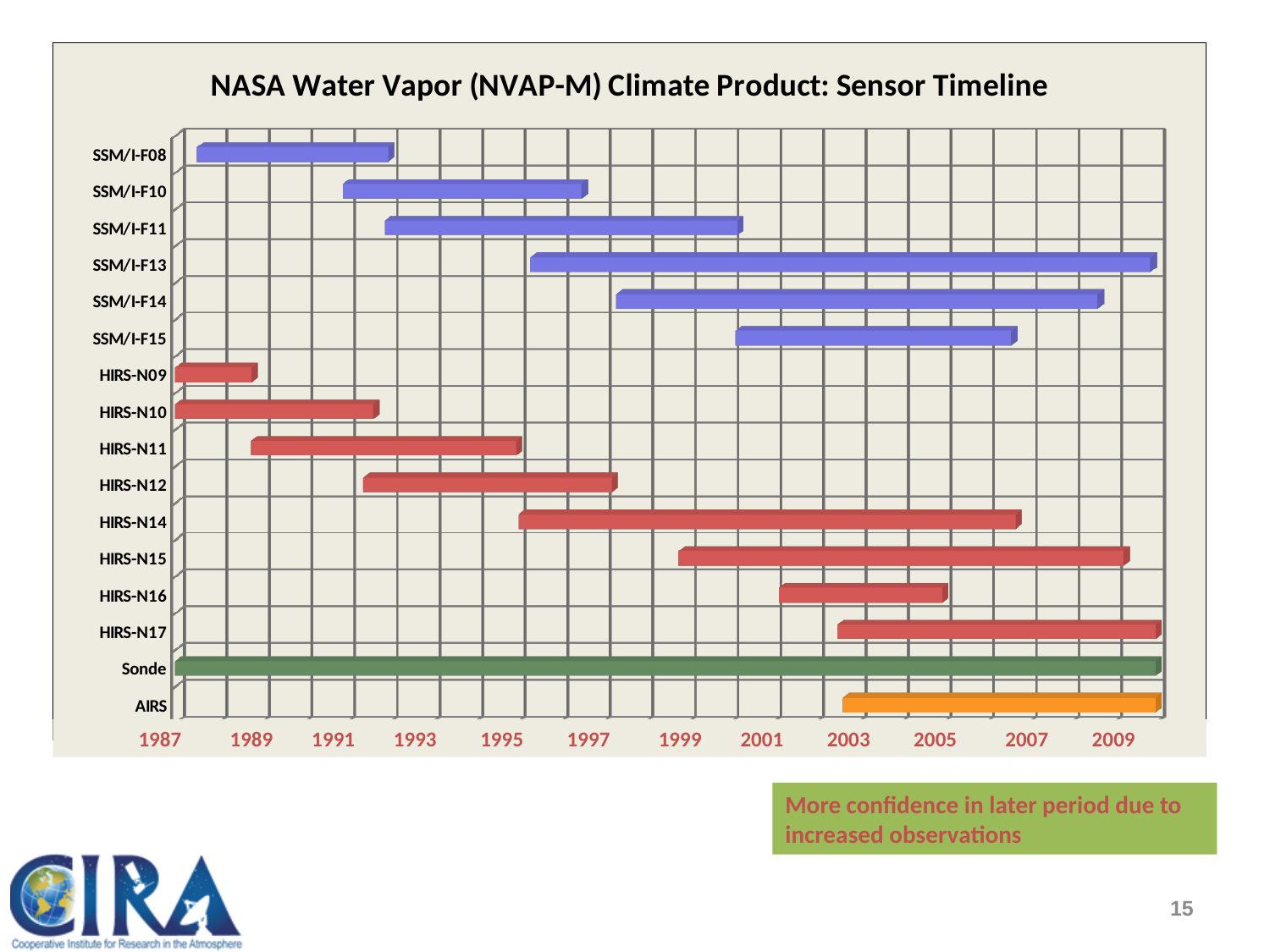
What is the title of the chart? NASA Water Vapor (NVAP-M) Climate Product: Sensor Timeline Is the end year of the HIRS-N16 bar greater or less than 2007? less Which sensor has the shortest bar (covers the shortest time span) in the chart? HIRS-N09 What kind of chart is shown on the slide? bar chart Which sensor has the longest bar (covers the longest time span) in the chart? Sonde What colour are the bars for the SSM/I sensors in the chart? blue How many sensors (categories) are listed on the vertical axis of the chart? 16 Is the start year of the AIRS bar greater or less than 2001? greater How many SSM/I sensors are shown in the timeline? 6 How many HIRS sensors are shown in the timeline? 8 Which sensor covers a longer time span, SSM/I-F13 or SSM/I-F15? SSM/I-F13 Is the end year of the SSM/I-F08 bar greater or less than 1993? less